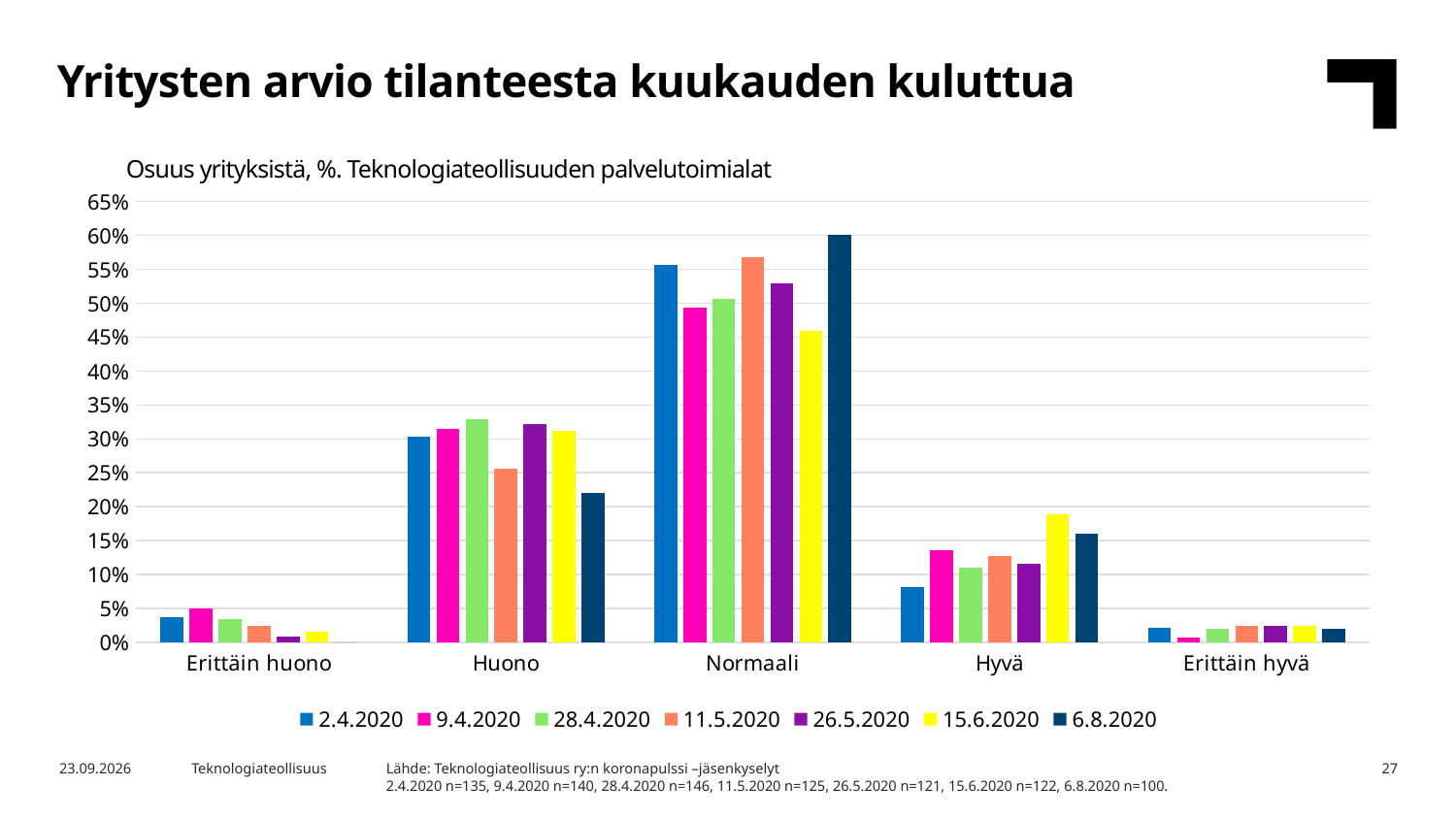
Is the value for Normaali in the 6.8.2020 series greater or less than 55%? greater Is the value for Hyvä in the 15.6.2020 series greater or less than 15%? greater What kind of chart is shown on the slide? Bar chart In the Hyvä category, which is larger: the 15.6.2020 value or the 2.4.2020 value? 15.6.2020 In the Huono category, which series has the lowest value? 6.8.2020 How many categories are shown on the x axis? 5 How many series does the legend list? 7 In the Normaali category, which series has the highest value? 6.8.2020 Is the value for Huono in the 6.8.2020 series greater or less than 25%? less What is the subtitle shown above the chart? Osuus yrityksistä, %. Teknologiateollisuuden palvelutoimialat For the 6.8.2020 series, which category has the highest value? Normaali In the Huono category, which is larger: the 28.4.2020 value or the 11.5.2020 value? 28.4.2020